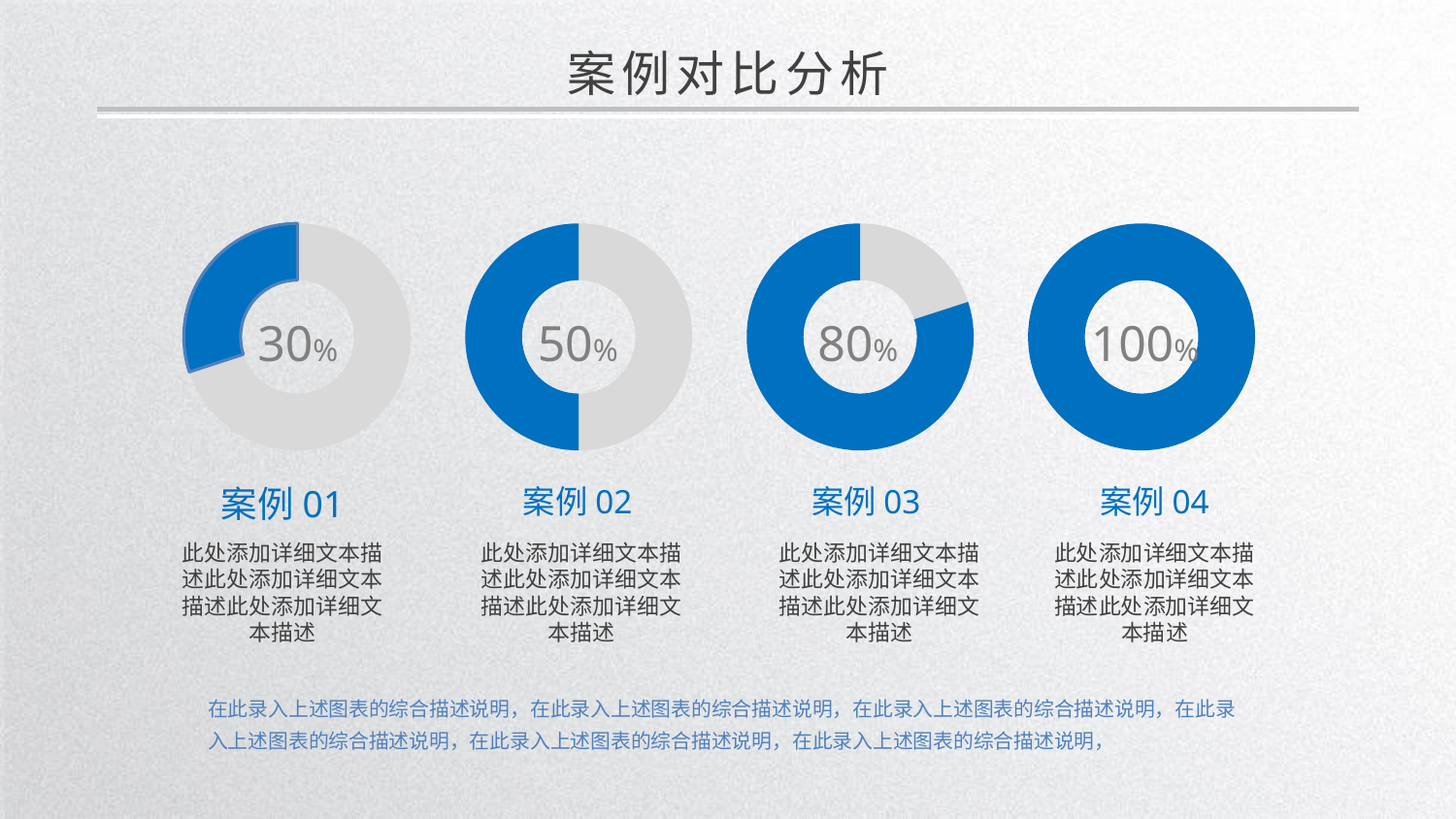
What percentage is shown in the donut chart for 案例 01? 30% Which case (案例) has the highest percentage among the four donut charts? 案例 04 What is the title of the slide containing the four donut charts? 案例对比分析 What percentage is shown in the donut chart for 案例 02? 50% Which has a larger percentage, 案例 02 or 案例 03? 案例 03 What kind of chart is used to show the percentage for each case on the slide? Donut chart Which case (案例) has the lowest percentage among the four donut charts? 案例 01 How many donut charts are shown on the slide? 4 Do the percentages rise or fall going from 案例 01 to 案例 04 across the slide? Rise What percentage is shown in the donut chart for 案例 04? 100% What percentage is shown in the donut chart for 案例 03? 80% What is the difference between the percentages shown for 案例 03 and 案例 01? 50%